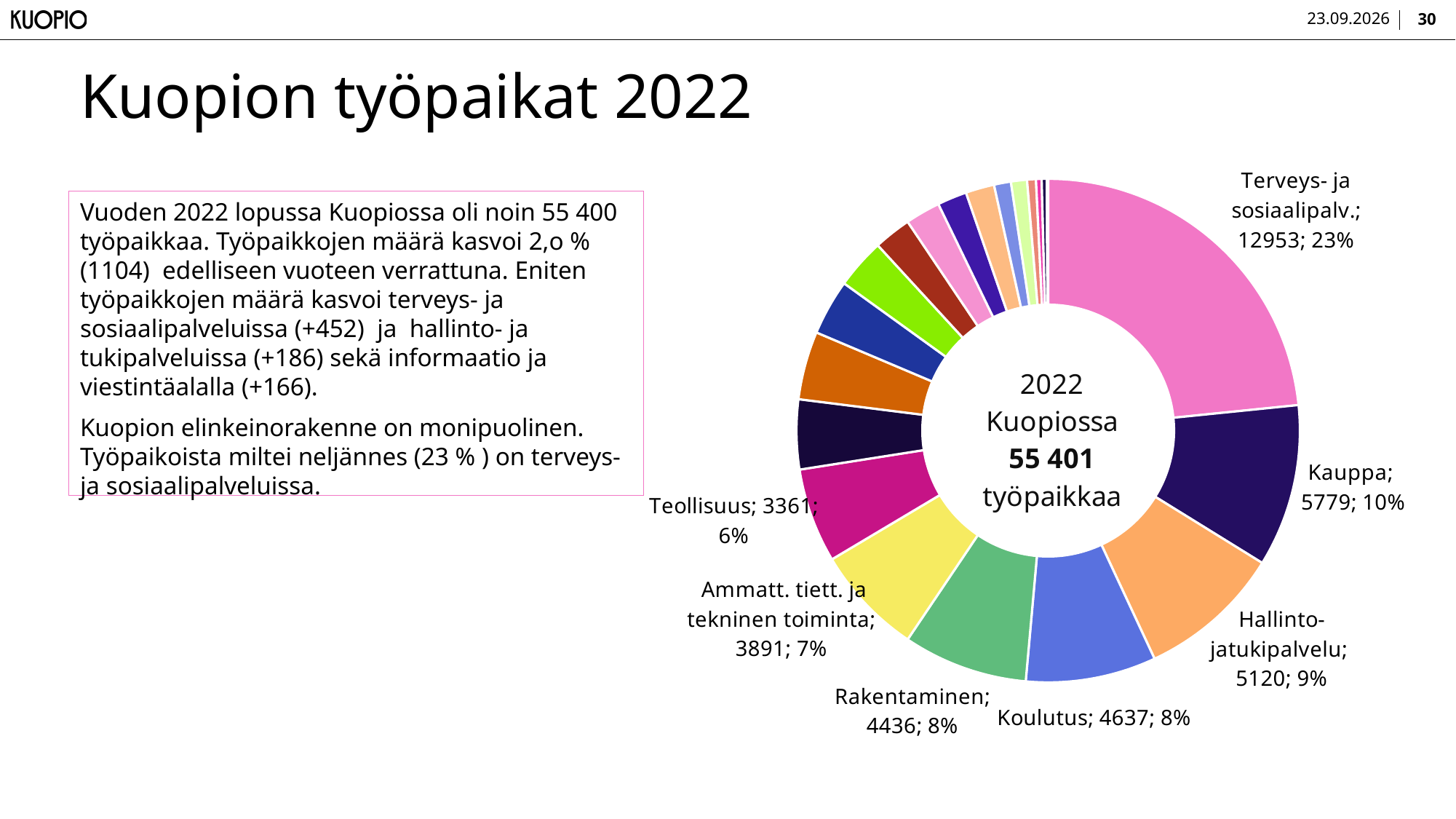
What value is shown for Rakentaminen? 4436 What kind of chart is shown on the slide? doughnut chart Which labelled sector has the largest slice in the chart? Terveys- ja sosiaalipalv. How many jobs does the chart show for Terveys- ja sosiaalipalv.? 12953 Which is larger, the value for Koulutus or the value for Rakentaminen? Koulutus What total number of jobs is printed in the centre of the chart? 55 401 What share of the pie does Teollisuus represent? 6% What share of the pie does Kauppa represent? 10% What value is shown for Kauppa? 5779 What is the difference between the values for Kauppa and Hallinto- ja tukipalvelu? 659 What value is shown for Koulutus? 4637 What is the difference between the values for Ammatt. tiett. ja tekninen toiminta and Teollisuus? 530